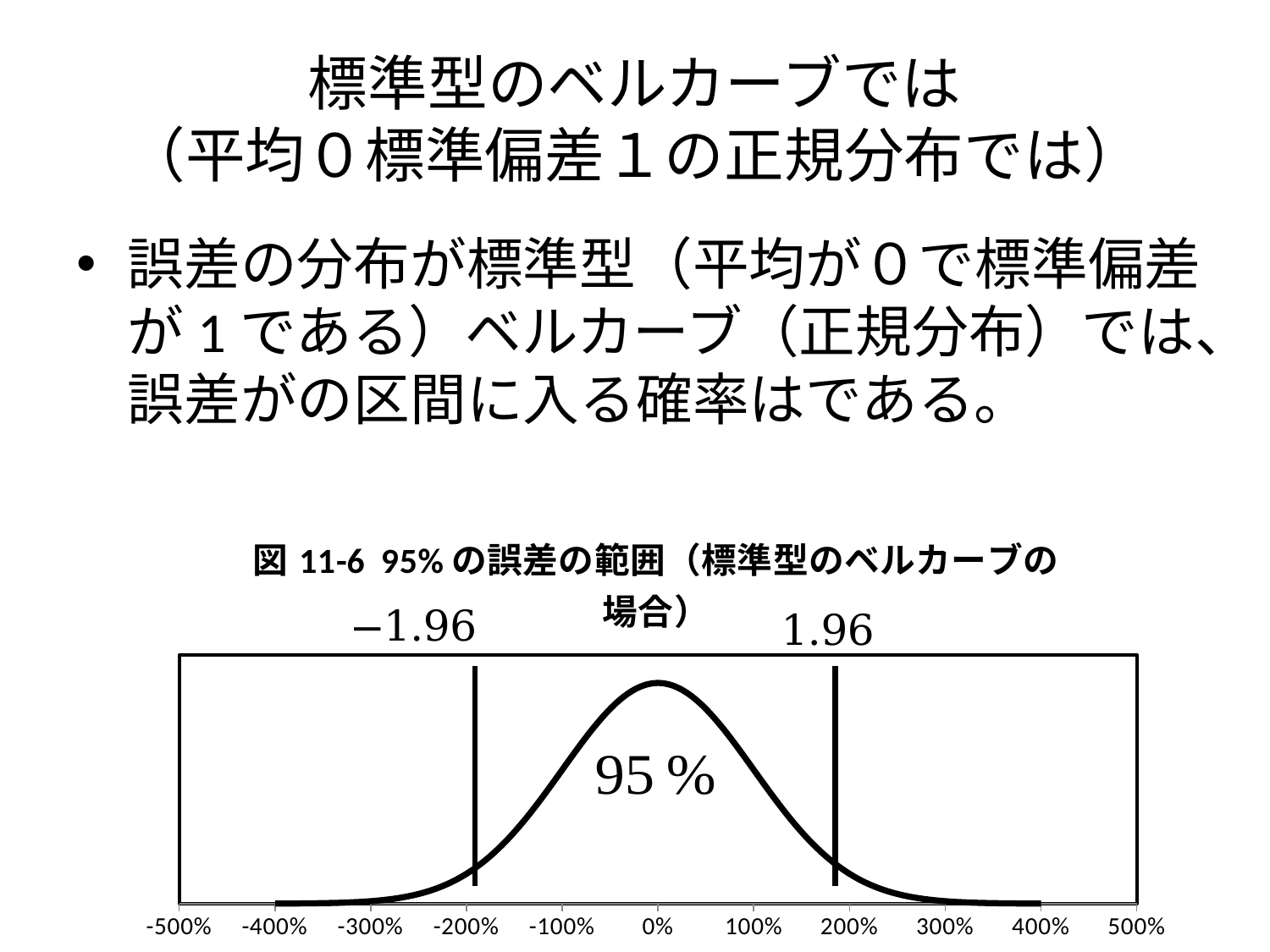
What is the title of the chart? 図 11-6 95% の誤差の範囲（標準型のベルカーブの場合） What percentage is printed inside the bell curve between the two vertical lines? 95％ Is the curve higher at 0% or at 300%? 0% At which x-axis tick does the curve reach its highest point? 0% Does the curve rise or fall as the x axis goes from 0% to 400%? fall Does the curve rise or fall as the x axis goes from -400% to 0%? rise What kind of chart is shown on the slide? line chart What is the rightmost tick label on the x axis? 500% What value is labelled above the left vertical line in the chart? −1.96 What is the leftmost tick label on the x axis? -500% What value is labelled above the right vertical line in the chart? 1.96 How many tick labels are shown on the x axis? 11